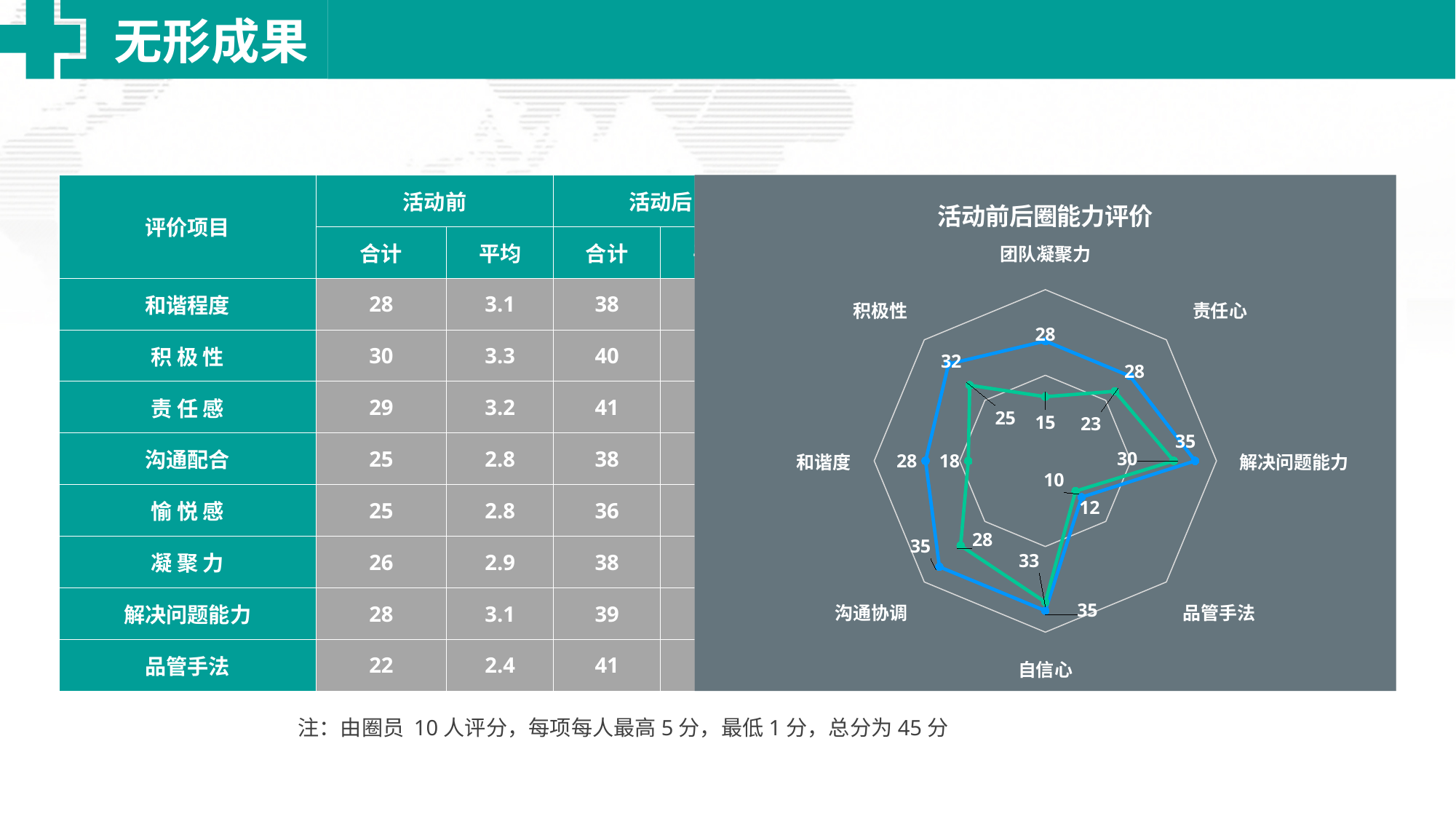
What is the value of the green series for 团队凝聚力? 15 What is the title of the chart? 活动前后圈能力评价 What is the value of the blue series for 积极性? 32 Which category has the highest value in the green series? 自信心 How many categories (axes) does the radar chart have? 8 Which category has the lowest value in the blue series? 品管手法 How many data series are plotted on the radar chart? 2 What is the difference between the blue and green values for 团队凝聚力? 13 What is the value of the blue series for 团队凝聚力? 28 For 解决问题能力, which series has the larger value, blue or green? Blue What kind of chart is shown on the slide? Radar chart What is the value of the green series for 和谐度? 18